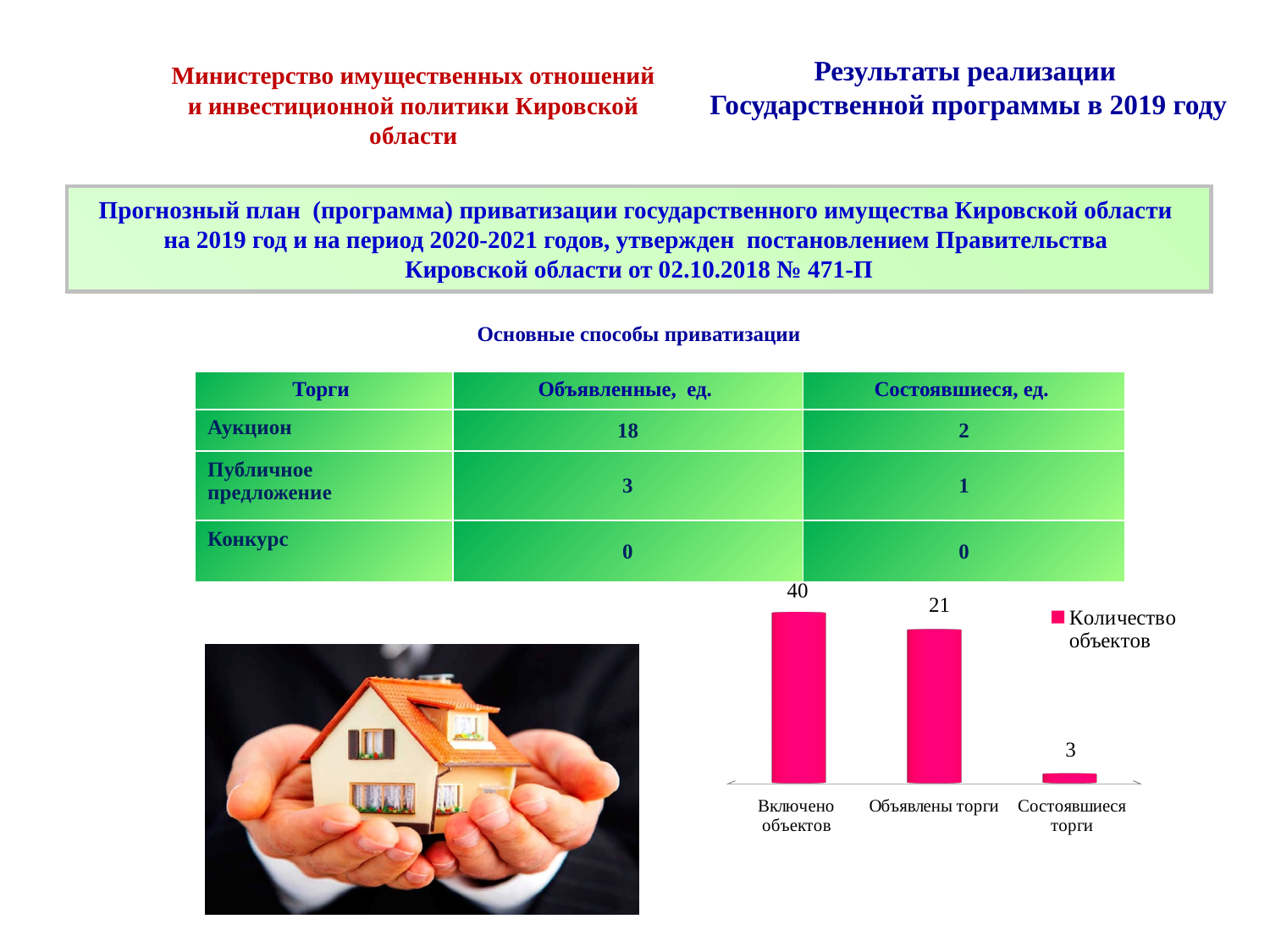
Which category has the lowest value? Состоявшиеся торги What is the value for "Включено объектов"? 40 How many series does the legend list? 1 Which category has the highest value? Включено объектов What is the value for "Состоявшиеся торги"? 3 What is the name of the series in the legend? Количество объектов What kind of chart is shown? bar chart How many categories are shown in the chart? 3 Which is larger: "Объявлены торги" or "Состоявшиеся торги"? Объявлены торги What is the value for "Объявлены торги"? 21 What is the difference between "Включено объектов" and "Объявлены торги"? 19 What is the difference between "Объявлены торги" and "Состоявшиеся торги"? 18